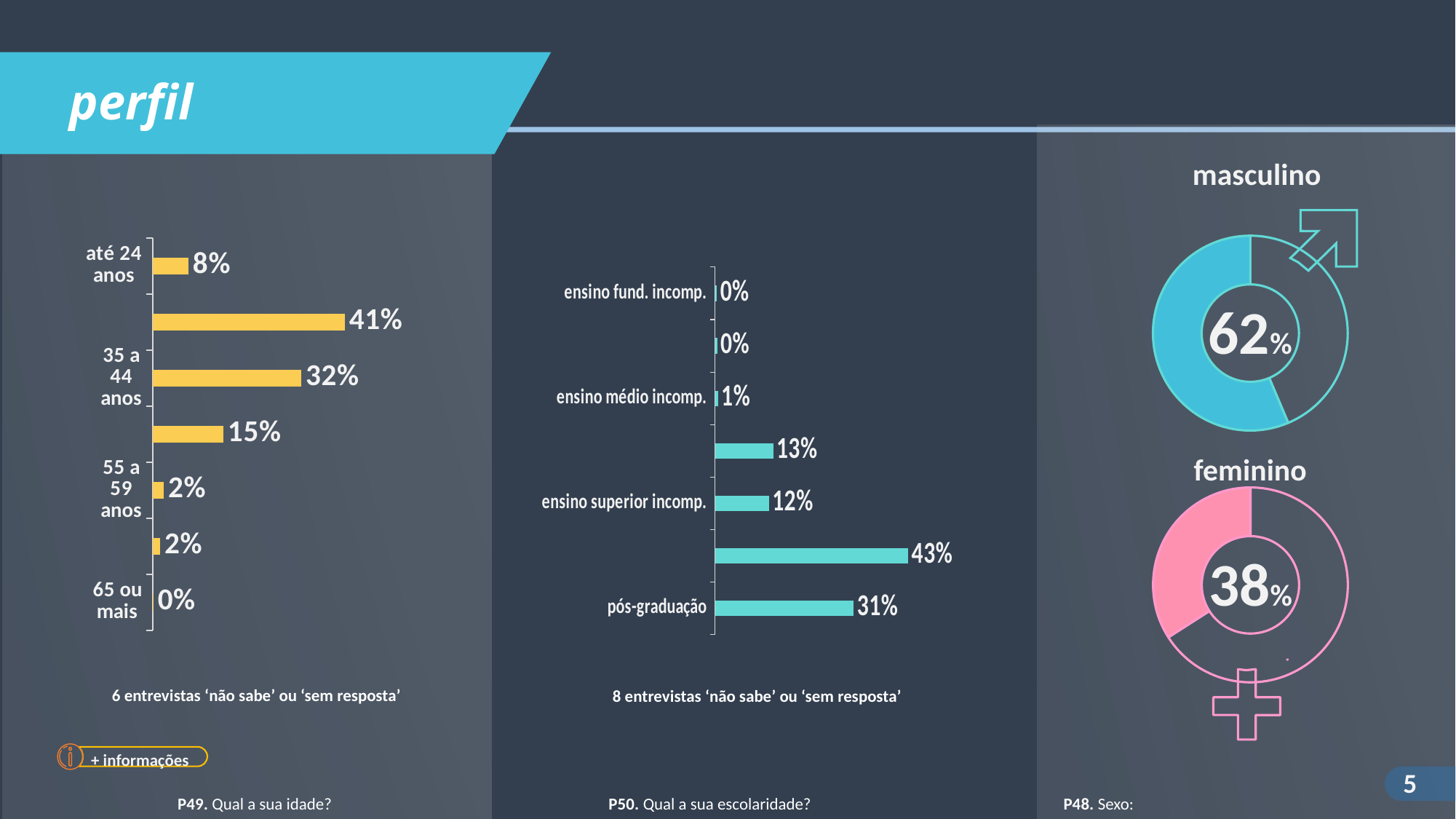
In the left chart (P49, age), what is the difference between the values for '35 a 44 anos' and 'até 24 anos'? 24% In the right chart (P48, Sexo), what is the share for 'masculino'? 62% In the middle chart (P50, education), what is the highest value shown on any bar? 43% In the middle chart (P50, education), what is the value for 'ensino superior incomp.'? 12% In the middle chart (P50, education), which is larger: 'pós-graduação' or 'ensino superior incomp.'? pós-graduação What kind of chart is the middle chart (P50, education)? bar chart In the left chart (P49, age), what is the value for 'até 24 anos'? 8% In the left chart (P49, age), how many bars are plotted? 7 In the left chart (P49, age), what is the value for '65 ou mais'? 0% In the middle chart (P50, education), what is the value for 'pós-graduação'? 31% In the left chart (P49, age), what is the highest value shown on any bar? 41% In the left chart (P49, age), what is the value for '35 a 44 anos'? 32%